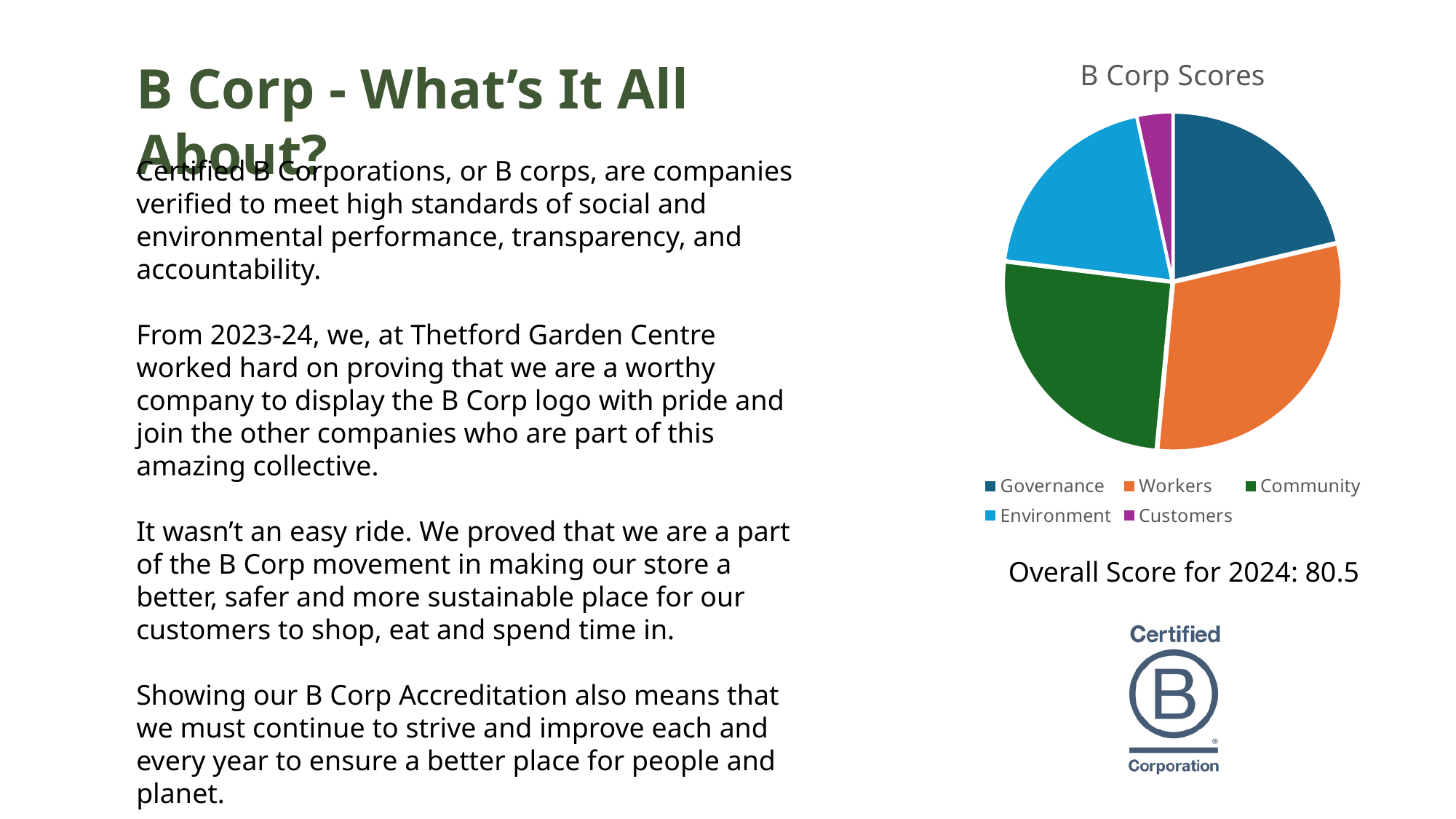
Which slice is larger, Workers or Governance? Workers Which category has the largest slice of the pie? Workers Which slice is larger, Workers or Customers? Workers Which category has the smallest slice of the pie? Customers What kind of chart is shown on the slide? pie chart How many categories does the pie chart show? 5 Which slice is larger, Community or Customers? Community What is the title of the chart? B Corp Scores What colour is the Community slice in the pie chart? green